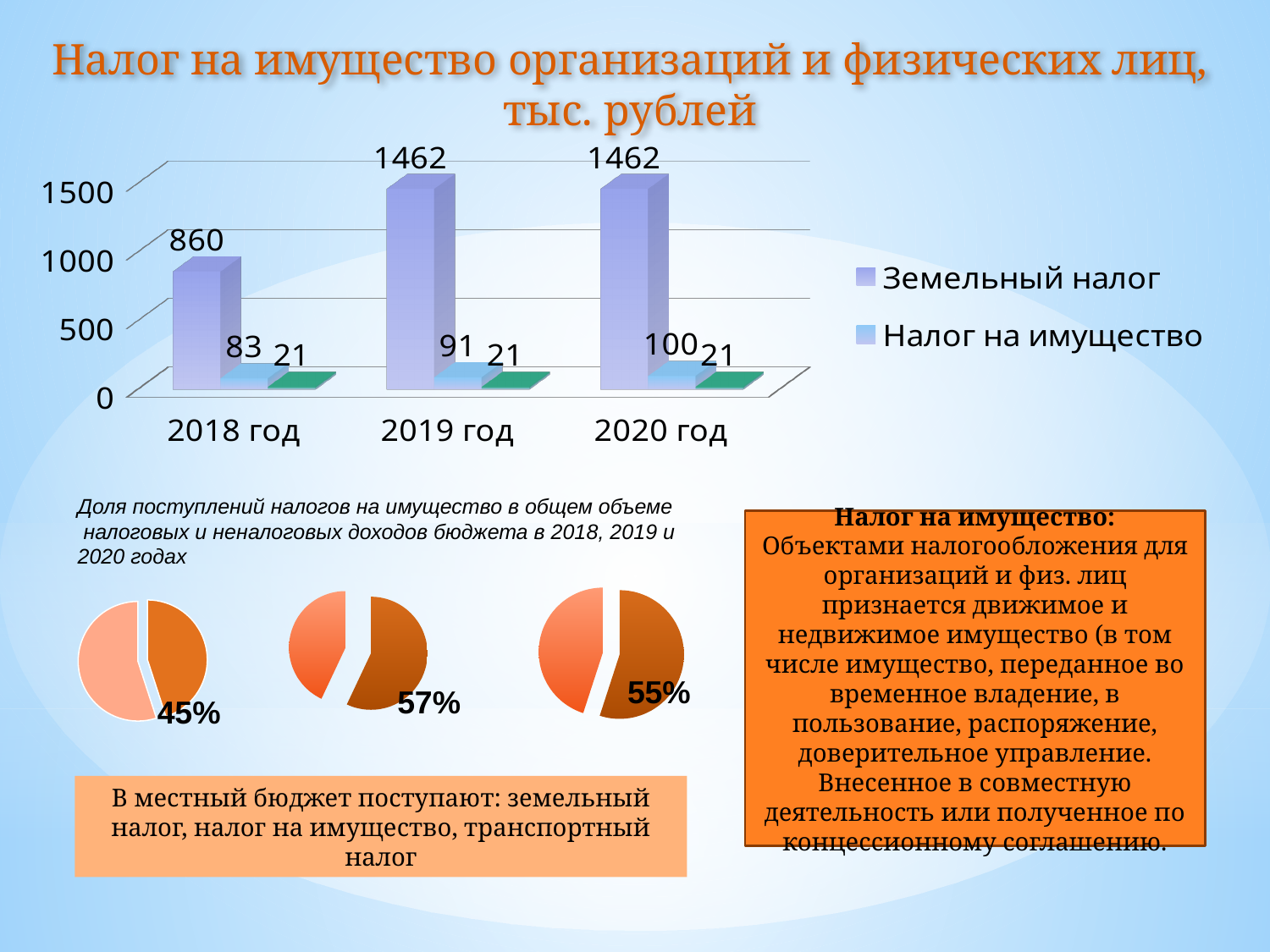
What percentage is labelled on the leftmost pie chart at the bottom of the slide? 45% In the bar chart 'Налог на имущество организаций и физических лиц, тыс. рублей', what is the value of Земельный налог for 2018 год? 860 In the bar chart 'Налог на имущество организаций и физических лиц, тыс. рублей', what is the value of Налог на имущество for 2019 год? 91 In the bar chart 'Налог на имущество организаций и физических лиц, тыс. рублей', does Налог на имущество rise or fall from 2018 год to 2020 год? Rise In the bar chart 'Налог на имущество организаций и физических лиц, тыс. рублей', how many series does the legend list? 2 In the bar chart 'Налог на имущество организаций и физических лиц, тыс. рублей', which year has the lowest value for Земельный налог? 2018 год In the bar chart 'Налог на имущество организаций и физических лиц, тыс. рублей', what is the value of Налог на имущество for 2020 год? 100 What kind of chart is the chart titled 'Налог на имущество организаций и физических лиц, тыс. рублей'? Bar chart In the bar chart 'Налог на имущество организаций и физических лиц, тыс. рублей', which is larger: Налог на имущество in 2018 год or in 2020 год? 2020 год In the bar chart 'Налог на имущество организаций и физических лиц, тыс. рублей', how many years are shown on the x axis? 3 In the bar chart 'Налог на имущество организаций и физических лиц, тыс. рублей', what is the difference between Земельный налог in 2019 год and in 2018 год? 602 In the bar chart 'Налог на имущество организаций и физических лиц, тыс. рублей', what is the difference between Налог на имущество in 2020 год and in 2018 год? 17